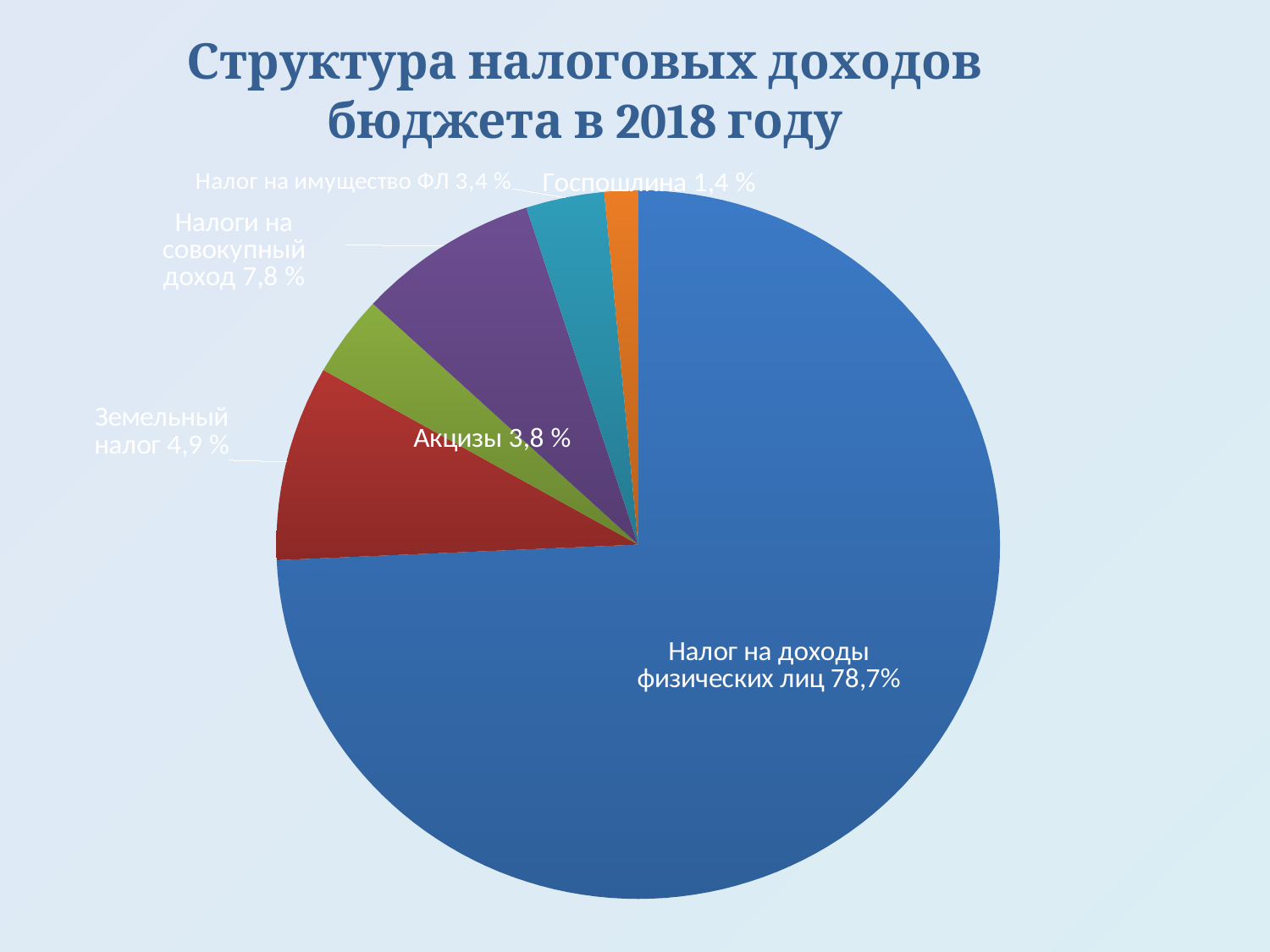
How many categories are shown in the pie chart? 6 Which is larger, Земельный налог or Акцизы? Земельный налог Which category has the smallest slice of the pie? Госпошлина What is the title of the chart? Структура налоговых доходов бюджета в 2018 году What share of tax revenues does Налог на доходы физических лиц account for? 78,7% What kind of chart is shown on the slide? pie chart What is the value shown for Акцизы? 3,8 % What is the difference between Налоги на совокупный доход and Налог на имущество ФЛ? 4,4 % What is the value shown for Госпошлина? 1,4 % What is the value shown for Земельный налог? 4,9 % What is the value shown for Налоги на совокупный доход? 7,8 % Which category has the largest slice of the pie? Налог на доходы физических лиц